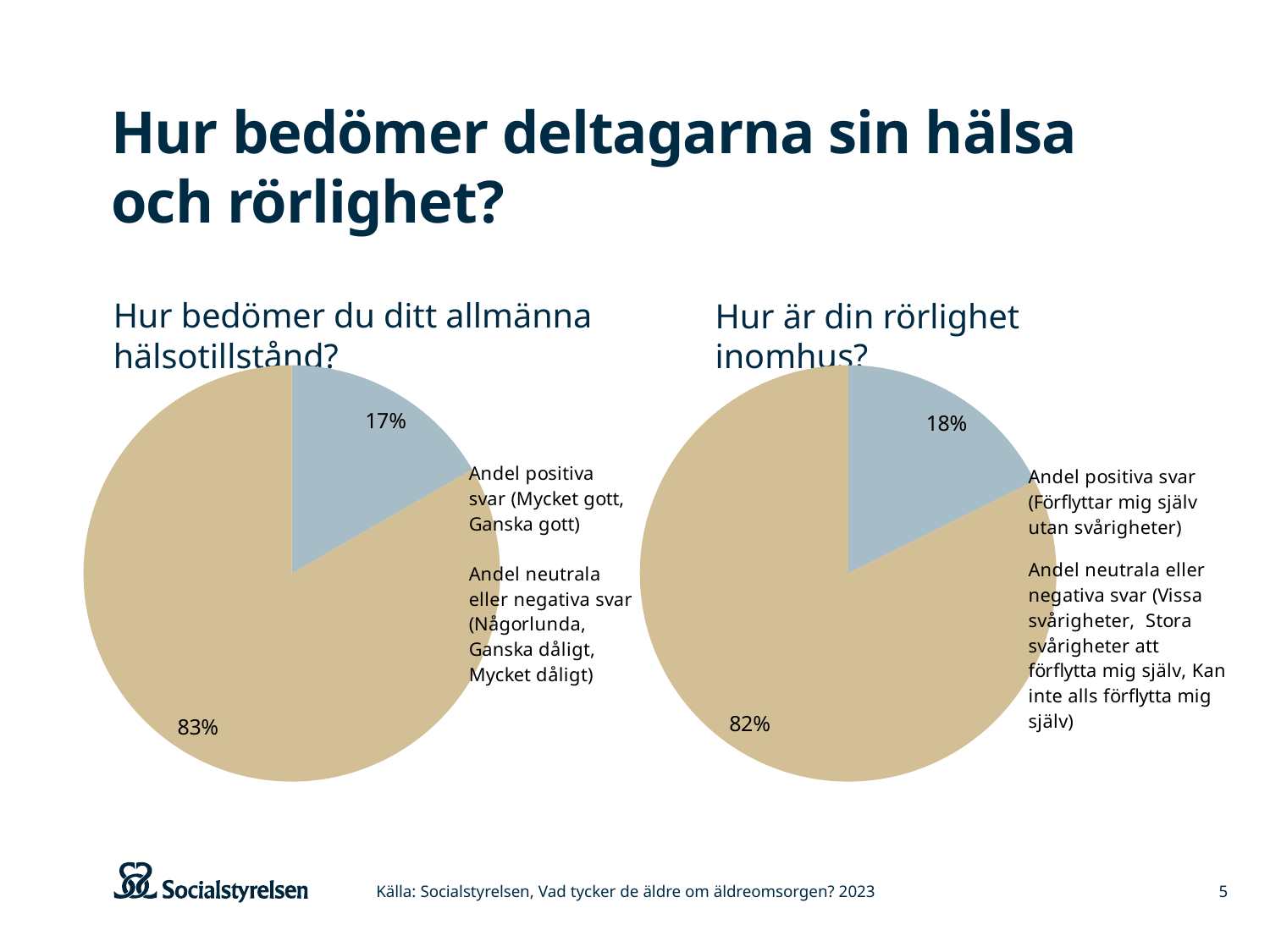
In the left chart, what is the difference in percentage points between the neutral/negative slice and the positive slice? 66 percentage points Which is larger: the positive share in the left chart or the positive share in the right chart? The right chart (18%) How many pie charts are shown on the slide? 2 How many slices does the chart titled "Hur är din rörlighet inomhus?" have? 2 In the left chart, what colour is the slice for "Andel positiva svar"? Light blue In the chart titled "Hur bedömer du ditt allmänna hälsotillstånd?", what share is labelled for "Andel positiva svar"? 17% In the right chart, which category has the smallest slice? Andel positiva svar What type of chart is used on this slide? Pie chart In the left chart, which category has the largest slice? Andel neutrala eller negativa svar In the chart titled "Hur bedömer du ditt allmänna hälsotillstånd?", what share is labelled for "Andel neutrala eller negativa svar"? 83% In the chart titled "Hur är din rörlighet inomhus?", what share is labelled for "Andel neutrala eller negativa svar"? 82% In the chart titled "Hur är din rörlighet inomhus?", what share is labelled for "Andel positiva svar"? 18%